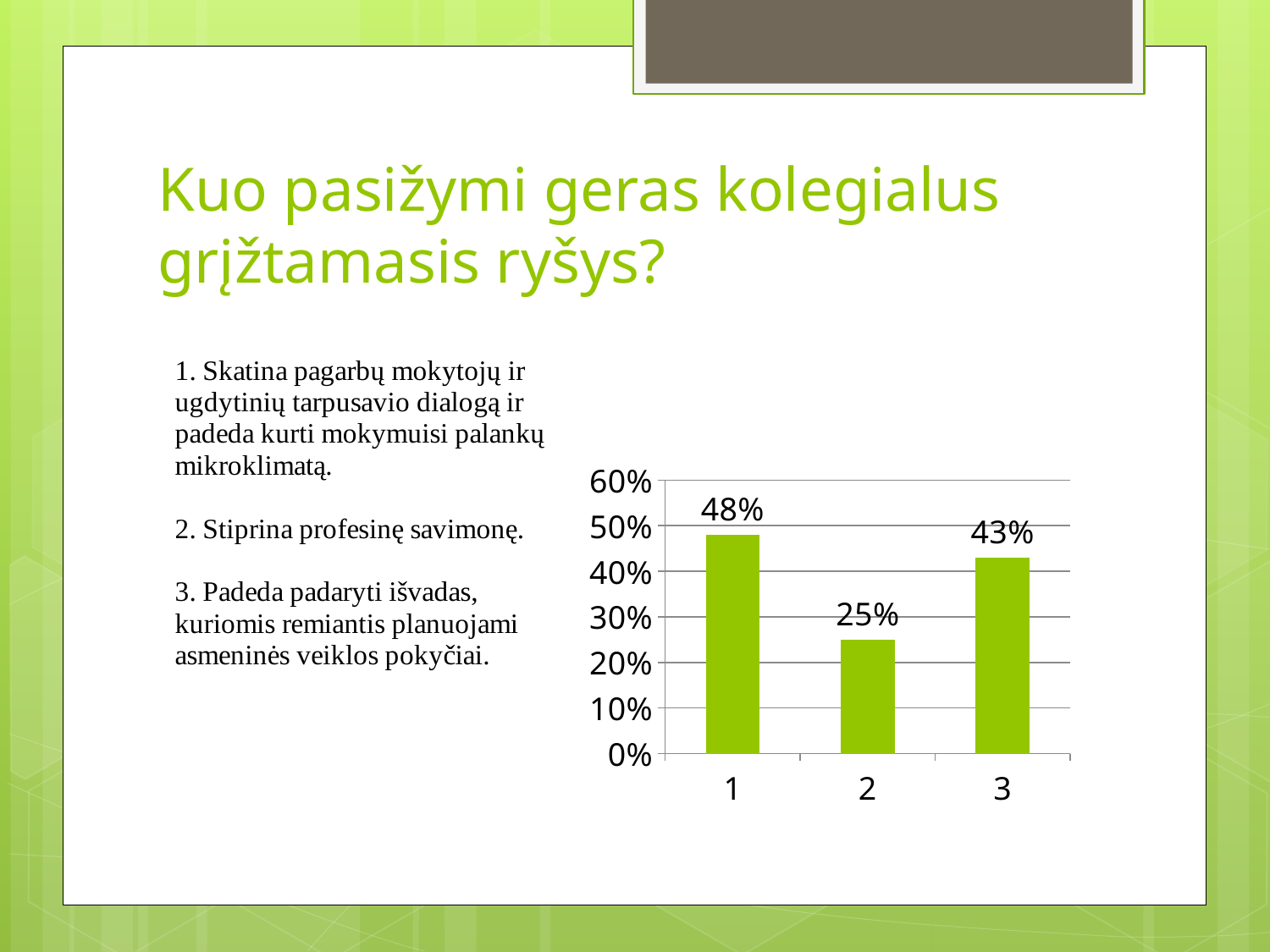
What is the value for category 1? 48% What is the value for category 2? 25% Which category has the highest value? 1 What is the highest value shown on the y axis? 60% Which is larger, the value for category 2 or category 3? 3 What kind of chart is shown on the slide? bar chart Which category has the lowest value? 2 How many categories are shown on the x axis? 3 What is the difference between the values for category 1 and category 3? 5% Is the value for category 2 greater or less than 30%? less What is the difference between the values for category 1 and category 2? 23% What is the value for category 3? 43%